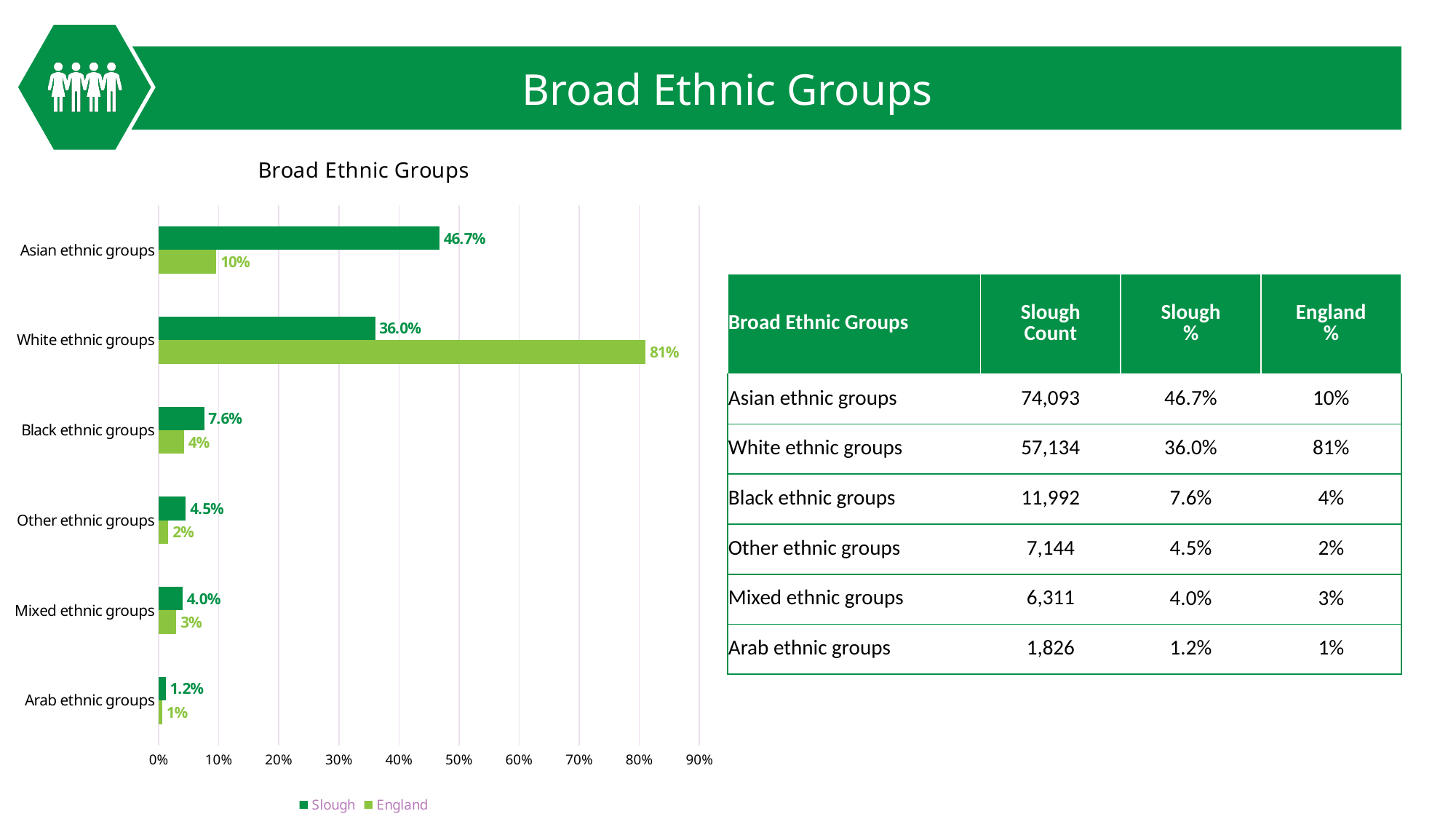
Which category has the lowest England value? Arab ethnic groups How many categories are shown on the chart? 6 How many series does the legend list? 2 Which category has the highest Slough value? Asian ethnic groups Which is larger for Other ethnic groups, the Slough value or the England value? Slough What is the Slough value for Asian ethnic groups? 46.7% What is the difference between the England and Slough values for White ethnic groups? 45.0% What is the England value for White ethnic groups? 81% Is the Slough value for White ethnic groups greater or less than 40%? less What is the England value for Mixed ethnic groups? 3% What is the Slough value for Black ethnic groups? 7.6% What kind of chart is shown? bar chart